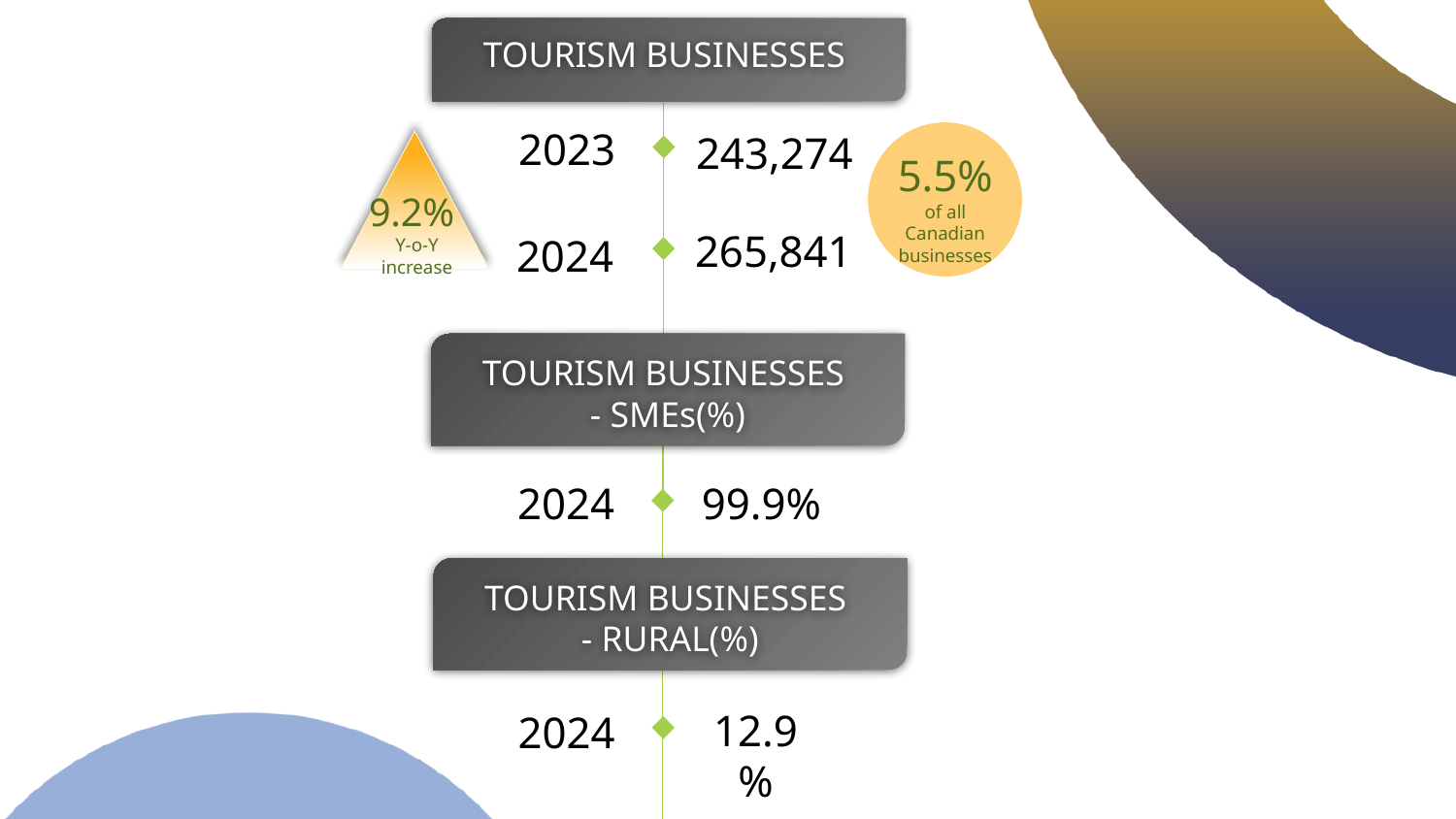
How many years are listed under the Tourism Businesses heading? 2 What is the heading of the top grey box on the slide? TOURISM BUSINESSES By how much did the number of tourism businesses increase from 2023 to 2024? 22,567 What is the year-over-year increase in tourism businesses shown in the triangle? 9.2% How many tourism businesses were there in 2023? 243,274 How many tourism businesses were there in 2024? 265,841 Which is larger, the SMEs percentage or the rural percentage of tourism businesses in 2024? SMEs percentage What percentage of tourism businesses were rural in 2024? 12.9% Which year had more tourism businesses, 2023 or 2024? 2024 What percentage of tourism businesses were SMEs in 2024? 99.9% Did the number of tourism businesses rise or fall from 2023 to 2024? rise What share of all Canadian businesses do tourism businesses represent, according to the circle? 5.5%